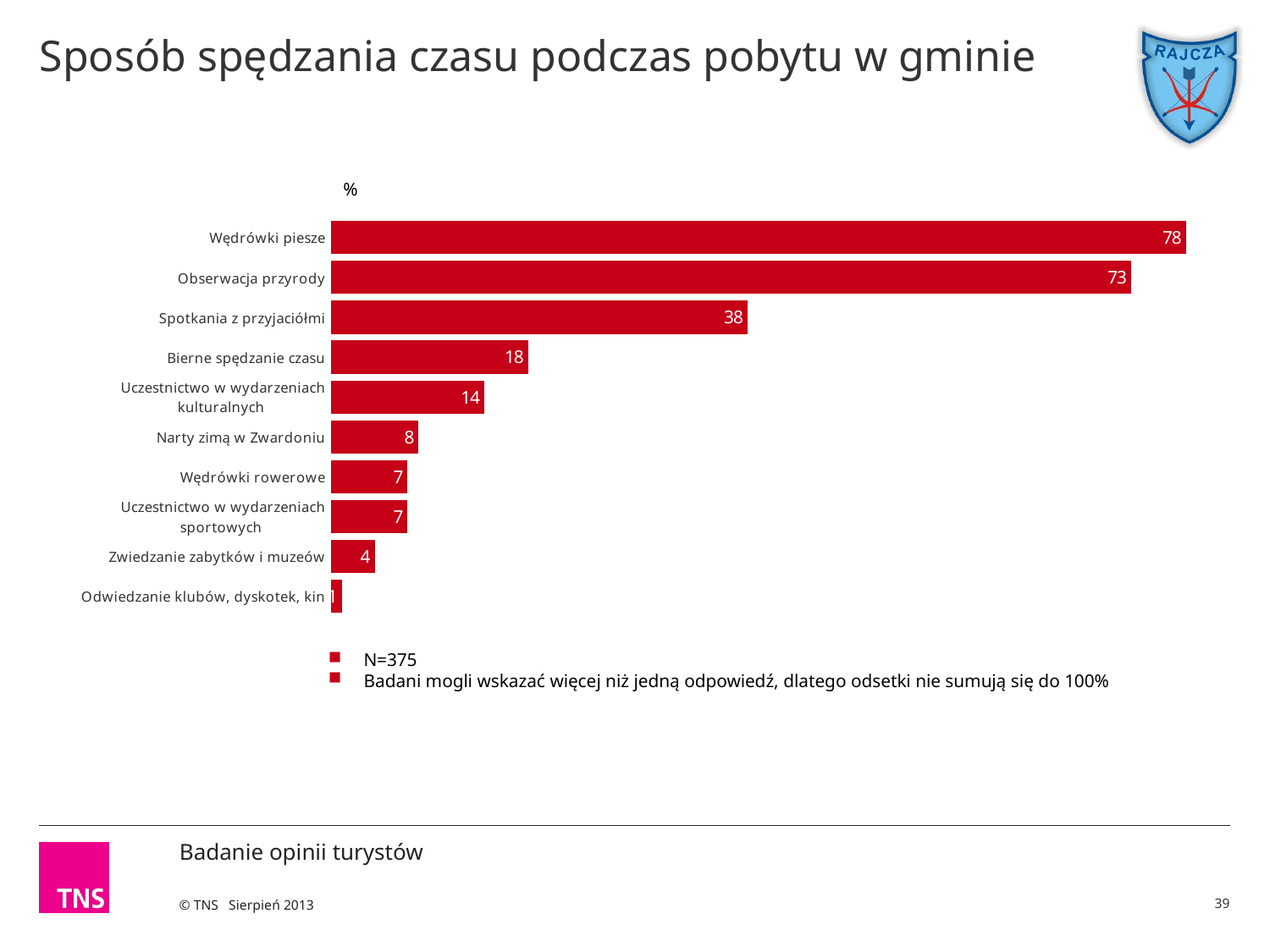
Which category has the highest value? Wędrówki piesze What is the value for Uczestnictwo w wydarzeniach kulturalnych? 14 What is the difference between the values for Spotkania z przyjaciółmi and Bierne spędzanie czasu? 20 What kind of chart is shown on the slide? Bar chart How many categories are shown in the chart? 10 Which category has the lowest value? Odwiedzanie klubów, dyskotek, kin What is the value for Wędrówki piesze? 78 What is the difference between the values for Wędrówki piesze and Obserwacja przyrody? 5 What is the value for Obserwacja przyrody? 73 What is the value for Spotkania z przyjaciółmi? 38 What is the value for Narty zimą w Zwardoniu? 8 Which is larger, the value for Bierne spędzanie czasu or the value for Zwiedzanie zabytków i muzeów? Bierne spędzanie czasu